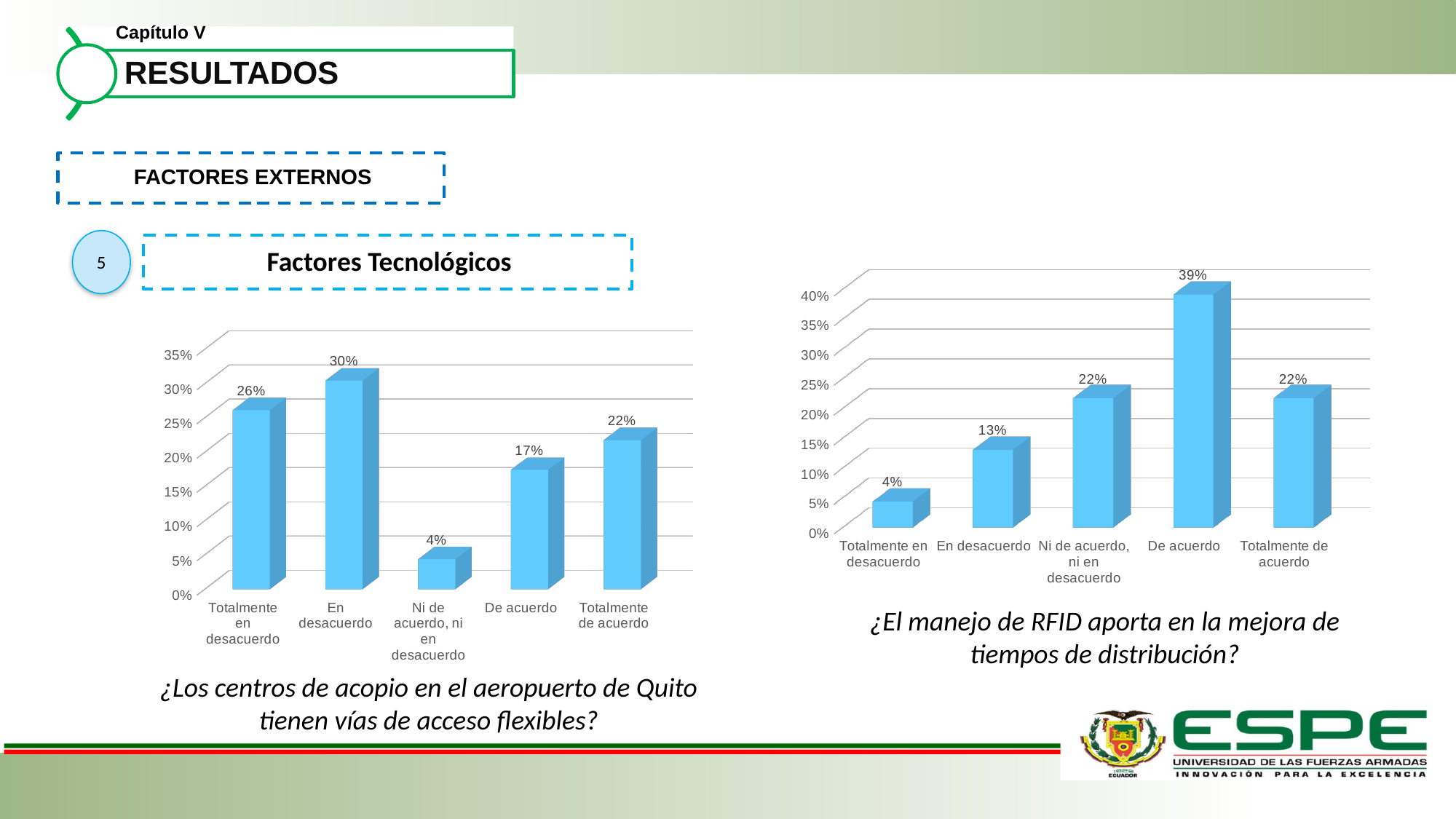
In the right chart (manejo de RFID), which category has the lowest value? Totalmente en desacuerdo In the left chart (vías de acceso flexibles), what is the value for 'Totalmente de acuerdo'? 22% What type of chart is the left chart (vías de acceso flexibles)? Bar chart In the left chart (vías de acceso flexibles), what is the value for 'En desacuerdo'? 30% In the left chart (vías de acceso flexibles), what is the difference between 'Totalmente en desacuerdo' and 'De acuerdo'? 9% How many categories are shown in the right chart (manejo de RFID)? 5 In the right chart (manejo de RFID), what is the value for 'De acuerdo'? 39% In the left chart (vías de acceso flexibles), which category has the lowest value? Ni de acuerdo, ni en desacuerdo In the right chart (manejo de RFID), what is the difference between 'De acuerdo' and 'Ni de acuerdo, ni en desacuerdo'? 17% In the left chart (vías de acceso flexibles), which category has the highest value? En desacuerdo In the right chart (manejo de RFID), what is the value for 'En desacuerdo'? 13% In the right chart (manejo de RFID), which is larger: 'De acuerdo' or 'Totalmente de acuerdo'? De acuerdo